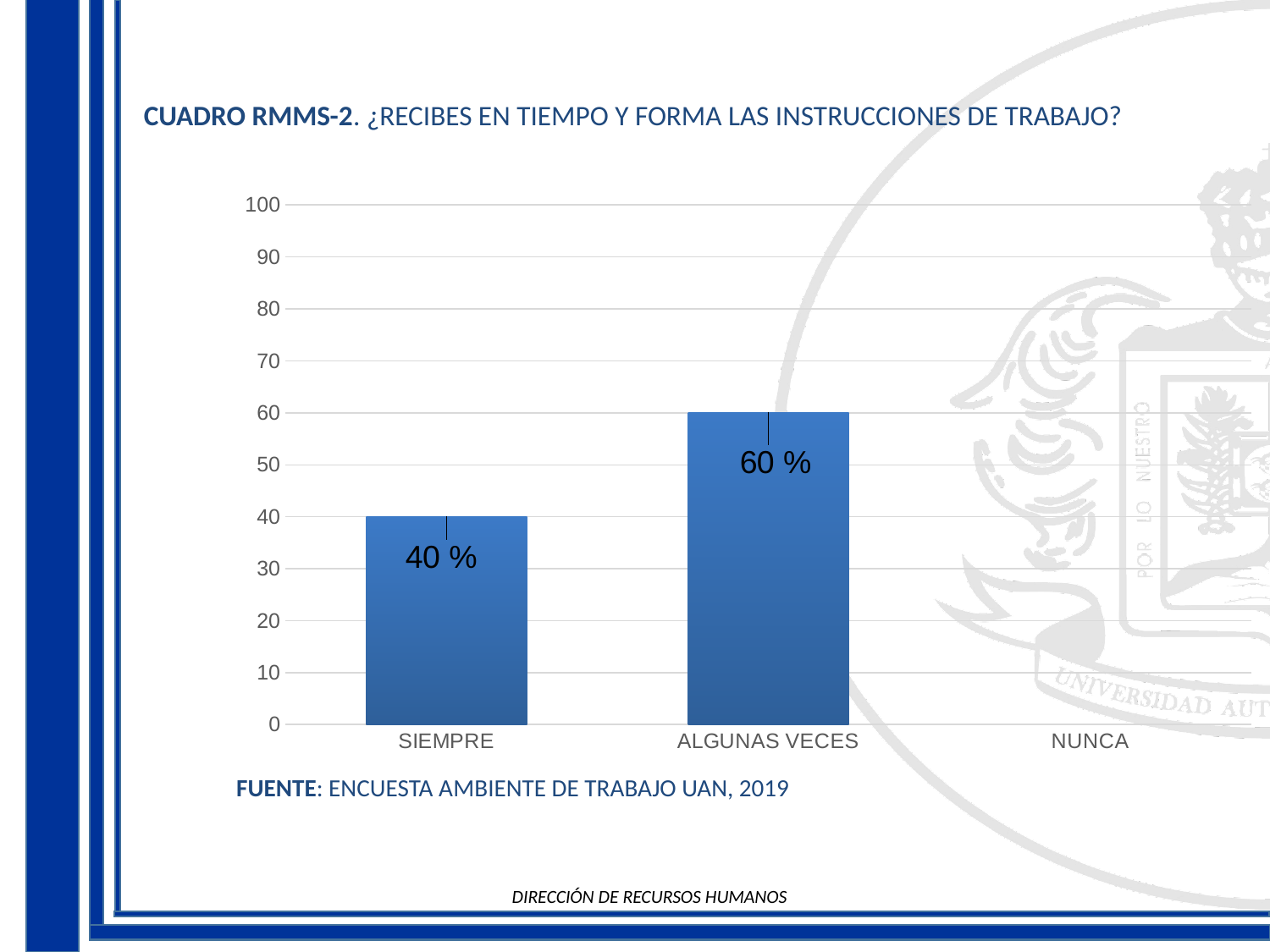
What kind of chart is shown on the slide? bar chart How many categories are shown on the x axis? 3 What is the maximum value shown on the y axis? 100 Is the value for ALGUNAS VECES greater or less than 50? greater Which is larger, the value for SIEMPRE or the value for ALGUNAS VECES? ALGUNAS VECES Which category has the highest value? ALGUNAS VECES What is the difference between the values for ALGUNAS VECES and SIEMPRE? 20 % What source is cited below the chart? ENCUESTA AMBIENTE DE TRABAJO UAN, 2019 What is the value for ALGUNAS VECES? 60 % What is the value for SIEMPRE? 40 % Is the value for SIEMPRE greater or less than 50? less